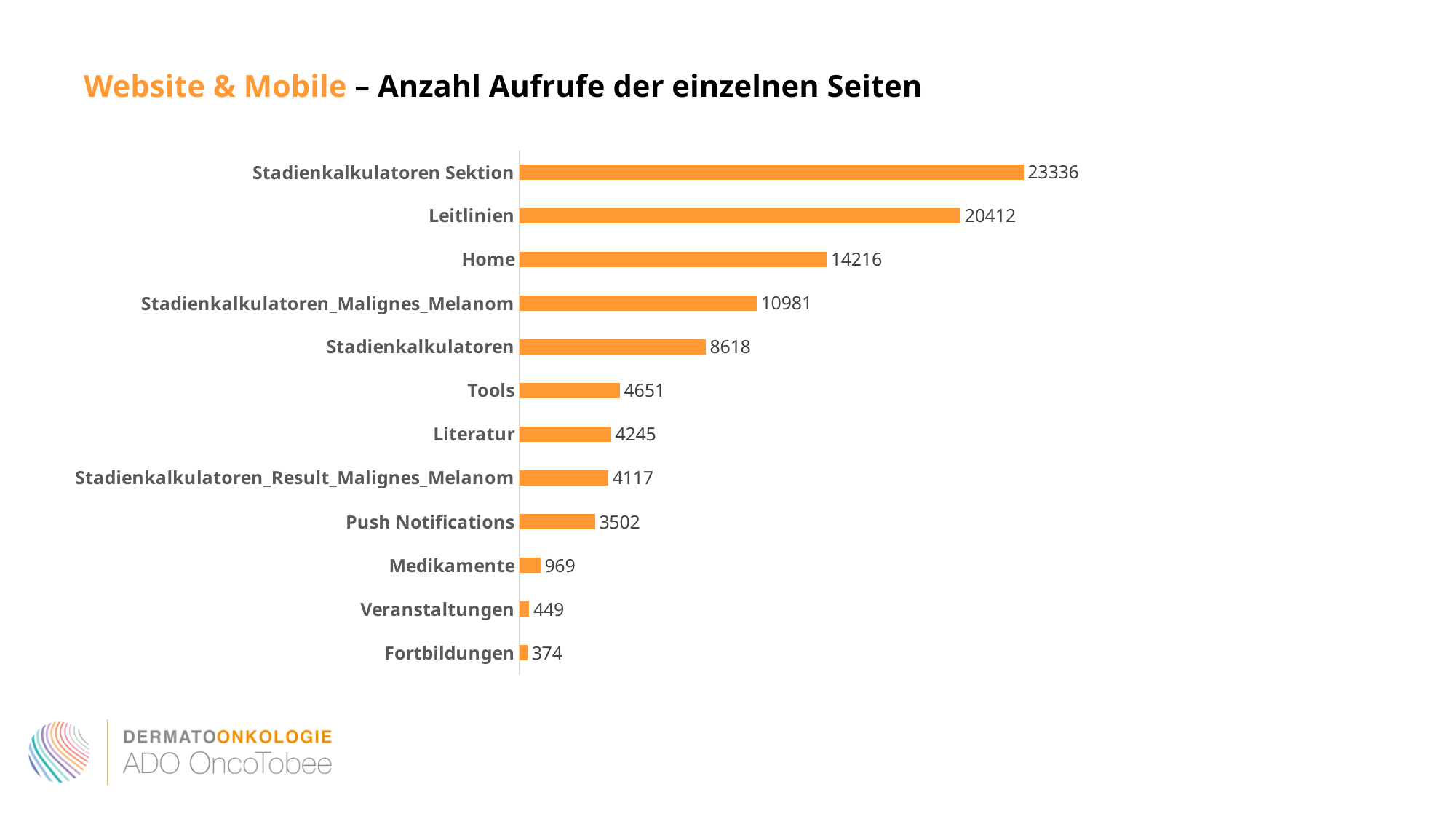
Which has a larger value, Medikamente or Veranstaltungen? Medikamente What is the difference between the values for Home and Stadienkalkulatoren? 5598 What colour are the bars in the chart? Orange What is the value shown for Push Notifications? 3502 What is the difference between the values for Stadienkalkulatoren Sektion and Leitlinien? 2924 Which has a larger value, Tools or Literatur? Tools What kind of chart is shown on the slide? Bar chart How many pages (categories) are shown in the chart? 12 What is the number of page views for Leitlinien? 20412 What is the value shown for Stadienkalkulatoren_Malignes_Melanom? 10981 Which page has the lowest number of views? Fortbildungen Which page has the highest number of views? Stadienkalkulatoren Sektion